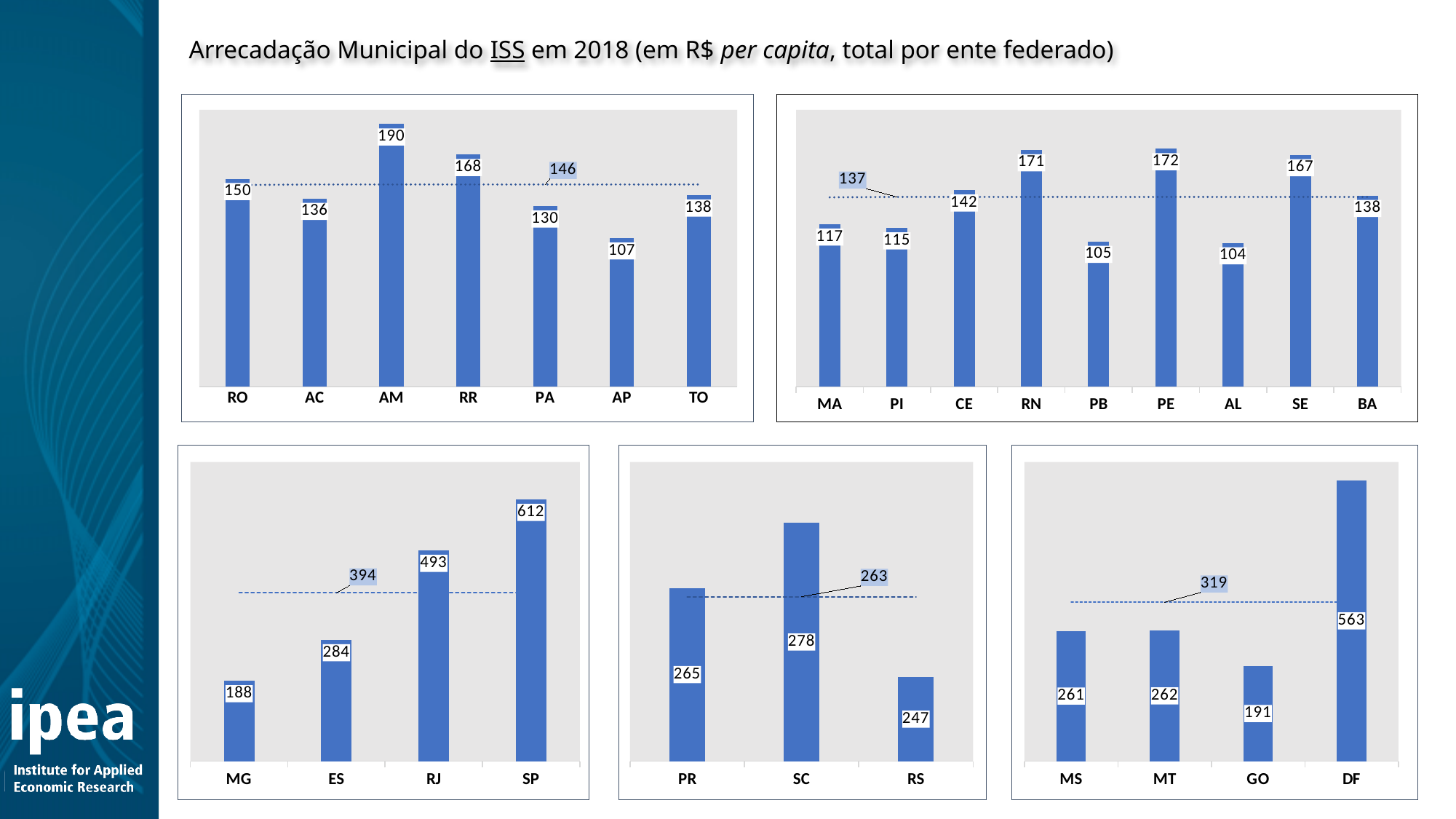
In the top-left chart, which state has the lowest value? AP In the bottom-left chart, what is the value for SP? 612 In the top-right chart, what is the value for PE? 172 In the bottom-middle chart, which state has the highest value? SC In the top-left chart, what is the value for AM? 190 In the top-right chart, how many states are shown on the x axis? 9 In the bottom-middle chart, what is the value for RS? 247 What value is labelled on the dotted reference line in the bottom-right chart? 319 In the bottom-left chart, what is the difference between the values for RJ and MG? 305 In the bottom-left chart, do the values rise or fall from MG to SP? rise In the top-right chart, which state has the lowest value? AL In the bottom-right chart, which is larger, the value for MS or the value for GO? MS